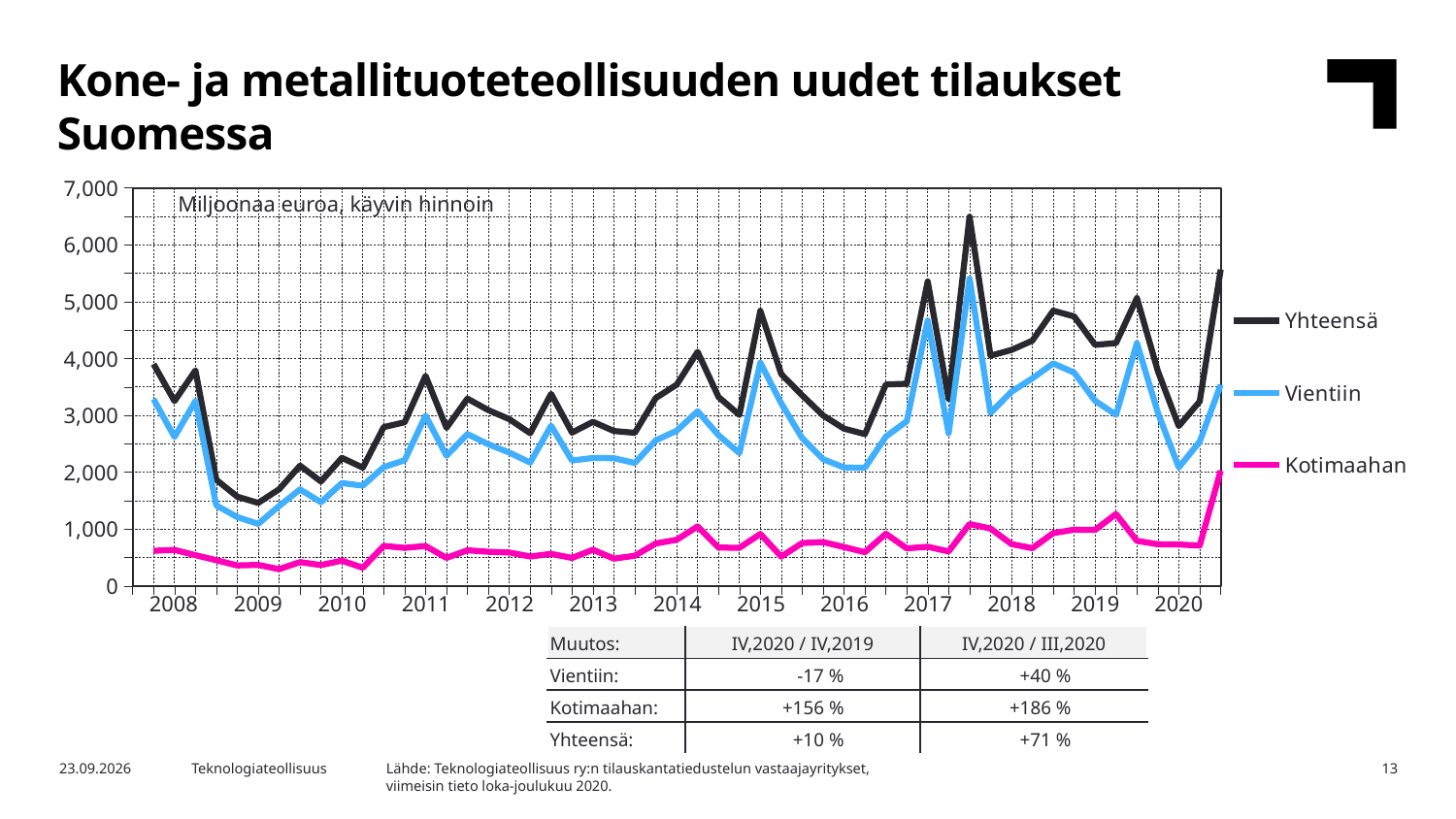
How many series does the legend list? 3 How many year labels are shown on the x axis? 13 Which series is larger in 2015, Vientiin or Kotimaahan? Vientiin Is the peak value of Yhteensä in 2017 greater or less than 6,000? greater Is the peak value of Vientiin in 2017 greater or less than 5,000? greater Is the lowest value of Vientiin in 2009 greater or less than 2,000? less Which series has the lowest values throughout the chart? Kotimaahan What are the three series named in the legend? Yhteensä, Vientiin, Kotimaahan What is the title of the chart on the slide? Kone- ja metallituoteteollisuuden uudet tilaukset Suomessa Which series has the highest values throughout the chart? Yhteensä What kind of chart is shown on the slide? line chart